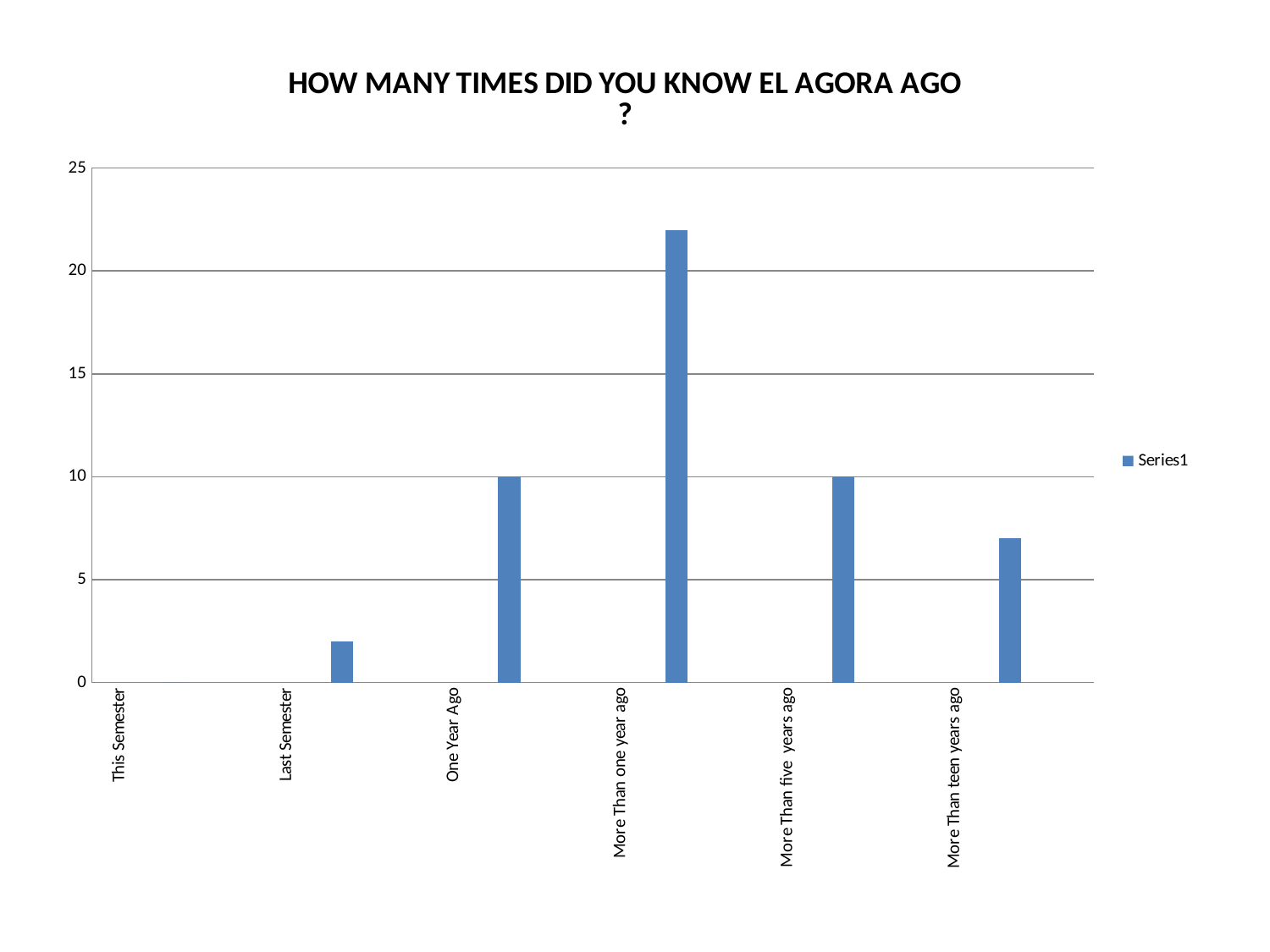
How many categories are shown on the x axis of the chart? 6 Which category has the highest value? More Than one year ago Is the value for Last Semester greater or less than 5? less Is the value for More Than one year ago greater or less than 20? greater What is the name of the series listed in the legend? Series1 Is the value for More Than teen years ago greater or less than 10? less Which is larger, the value for One Year Ago or the value for Last Semester? One Year Ago What is the value for One Year Ago? 10 How many series does the legend list? 1 What kind of chart is shown on the slide? bar chart What is the value for More Than five years ago? 10 Which category has the lowest value? This Semester